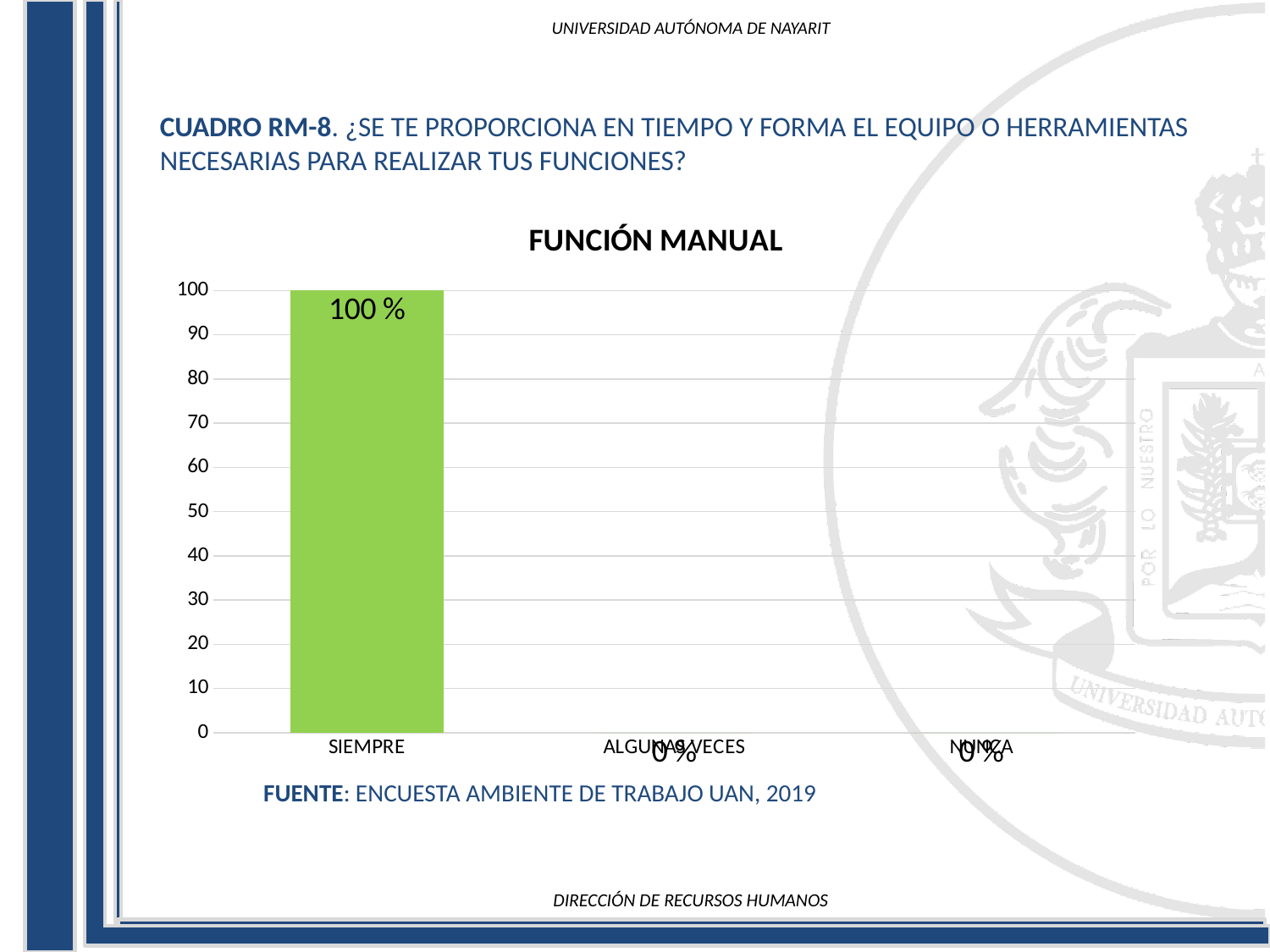
What is the value for NUNCA? 0 % What is the value for ALGUNAS VECES? 0 % Which is larger, the value for SIEMPRE or the value for ALGUNAS VECES? SIEMPRE Which category has the highest value? SIEMPRE What kind of chart is this? bar chart What is the title of the chart? FUNCIÓN MANUAL Do the values rise or fall from SIEMPRE to NUNCA along the x axis? fall What is the difference between the values for SIEMPRE and NUNCA? 100 % Is the value for SIEMPRE greater or less than 50? greater What is the value for SIEMPRE? 100 % How many categories are shown on the x axis? 3 What is the highest value shown on the vertical axis? 100